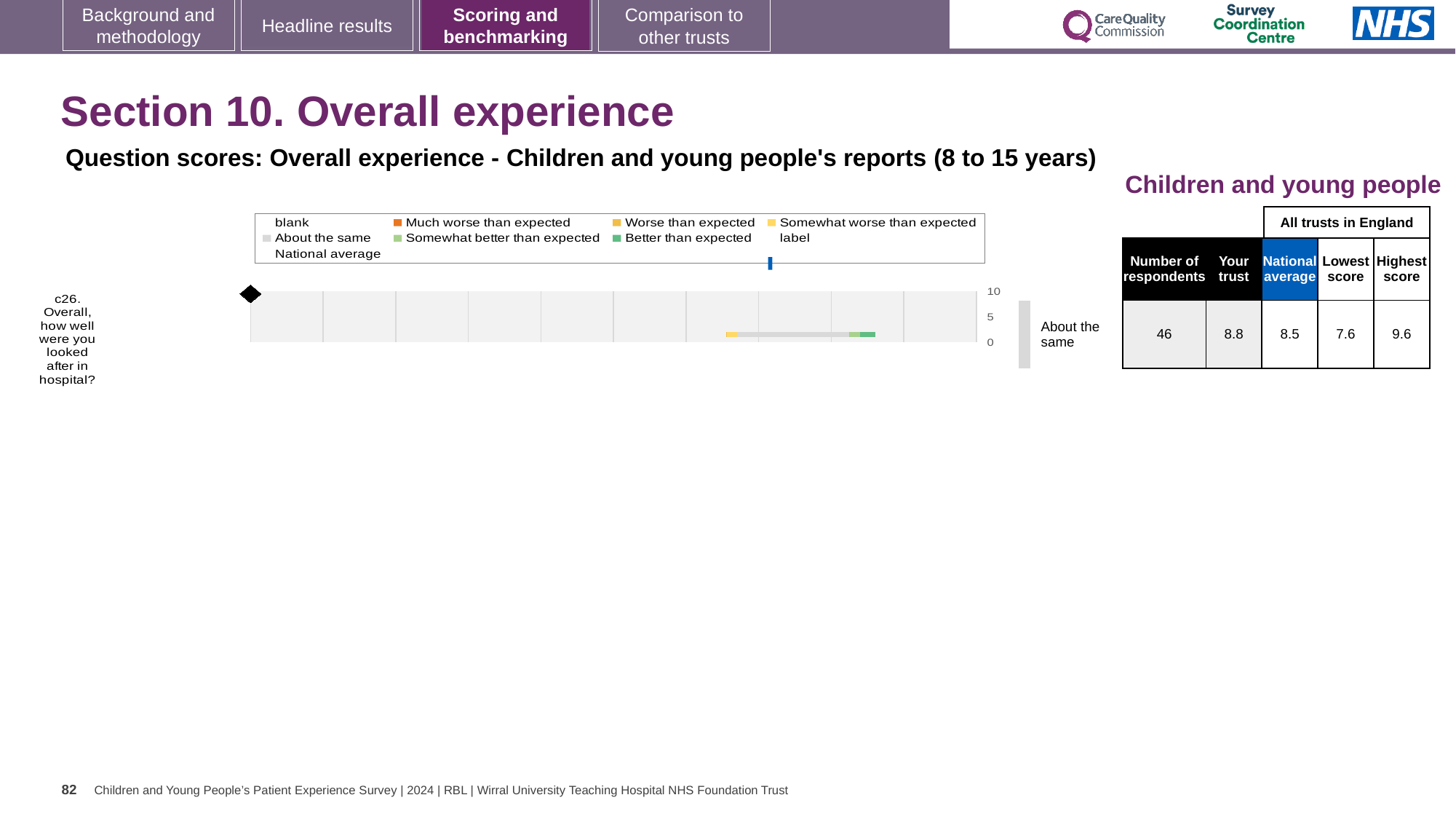
In the table next to the chart, what is the national average score for question c26? 8.5 What benchmark category label is shown to the right of the chart for question c26? About the same In the table next to the chart, what is the 'Your trust' score for question c26? 8.8 Is the 'Your trust' score for question c26 larger or smaller than the national average? larger In the table next to the chart, what is the lowest score among all trusts in England for question c26? 7.6 In the table next to the chart, what is the highest score among all trusts in England for question c26? 9.6 What is the difference between the highest and lowest scores among all trusts in England for question c26? 2.0 Which question is plotted in the chart? c26. Overall, how well were you looked after in hospital? In the table next to the chart, how many respondents answered question c26? 46 How many survey questions are plotted in the chart? 1 What is the difference between the 'Your trust' score and the national average for question c26? 0.3 What type of chart is shown on the slide? bar chart